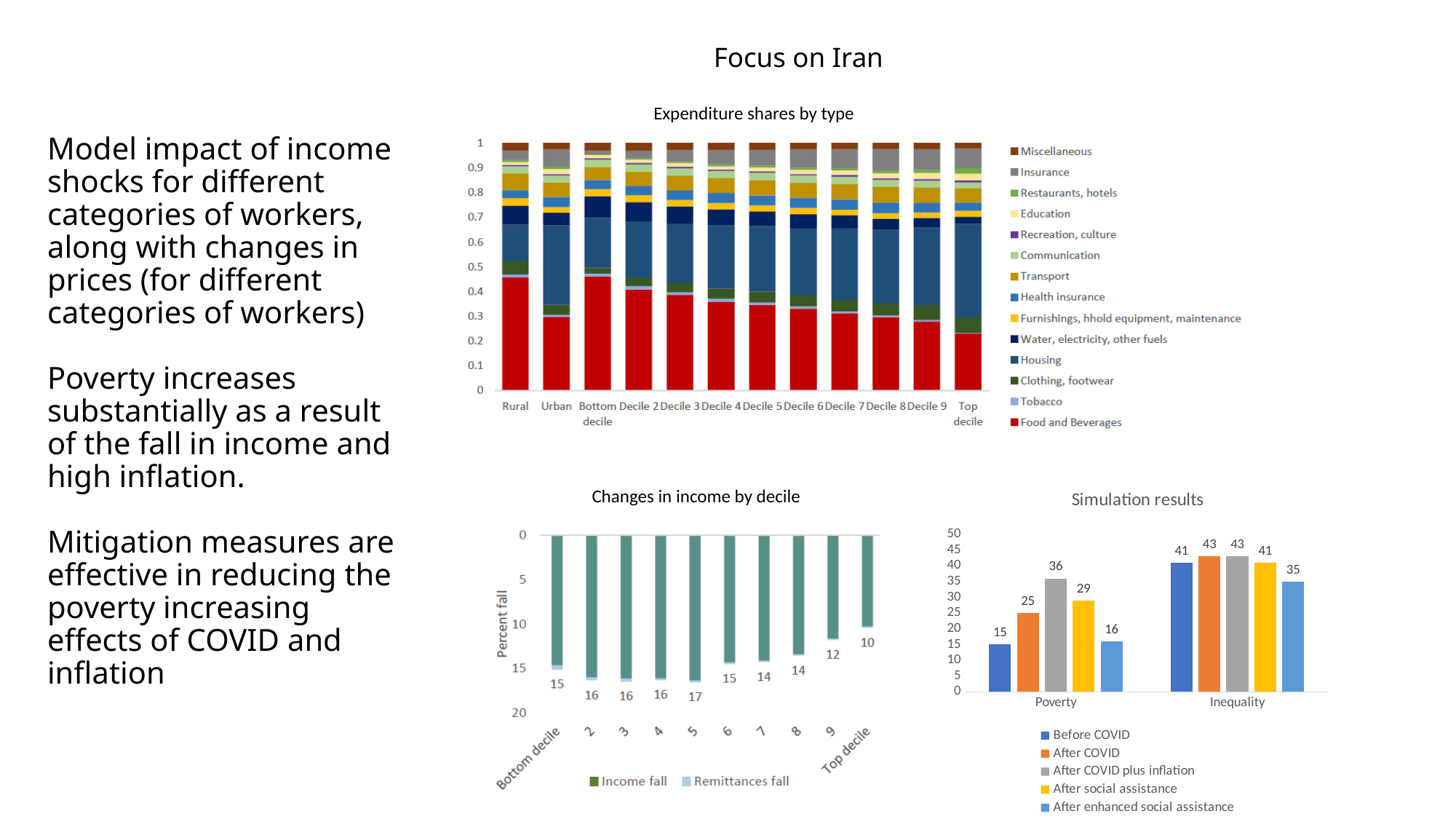
In the Simulation results chart, which is larger: the Poverty value for After COVID or for After enhanced social assistance? After COVID What kind of chart is the Expenditure shares by type chart? Stacked bar chart In the Changes in income by decile chart, what value is labelled for decile 5? 17 In the Changes in income by decile chart, which decile has the smallest labelled percent fall? Top decile In the Expenditure shares by type chart, is the Food and Beverages share for the Top decile greater or less than 0.3? less In the Simulation results chart, which series has the lowest Poverty value? Before COVID In the Changes in income by decile chart, what value is labelled for the Top decile? 10 How many series does the legend of the Simulation results chart list? 5 In the Simulation results chart, what is the Inequality value for After enhanced social assistance? 35 How many categories are shown on the x axis of the Expenditure shares by type chart? 12 In the Simulation results chart, what is the difference between the Poverty values for After COVID plus inflation and After social assistance? 7 In the Simulation results chart, what is the Poverty value for After COVID plus inflation? 36